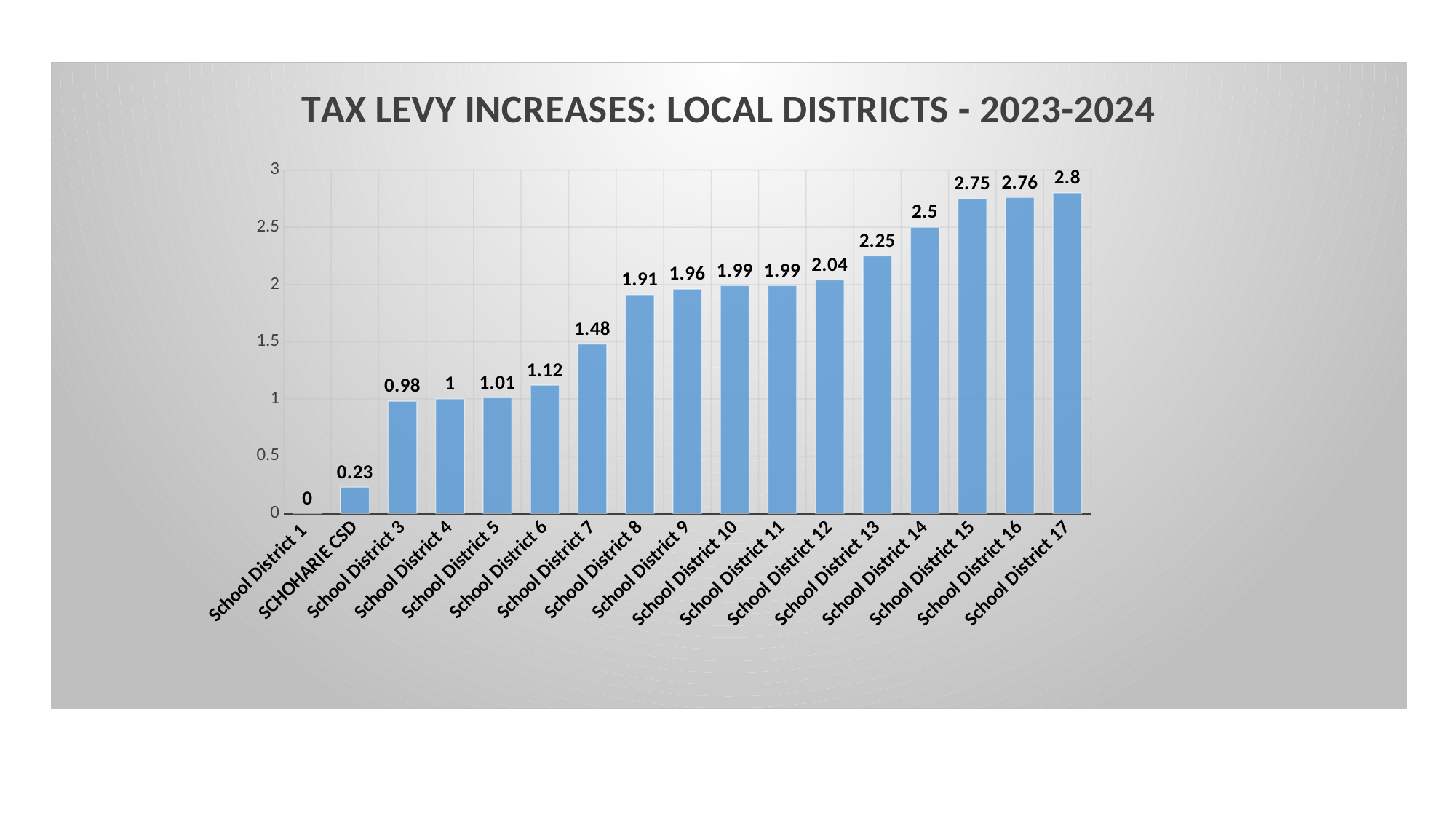
What is the tax levy increase value for SCHOHARIE CSD? 0.23 What is the difference between the values for School District 14 and School District 8? 0.59 Is the value for School District 9 greater or less than 1.5? greater What is the value shown for School District 7? 1.48 Which district has the lowest tax levy increase? School District 1 Which district has the highest tax levy increase? School District 17 Which is larger, the value for School District 12 or School District 6? School District 12 How many districts are shown on the chart? 17 What is the difference between the values for School District 17 and SCHOHARIE CSD? 2.57 What kind of chart is shown on the slide? Bar chart What is the title of the chart? TAX LEVY INCREASES: LOCAL DISTRICTS - 2023-2024 What is the value shown for School District 13? 2.25